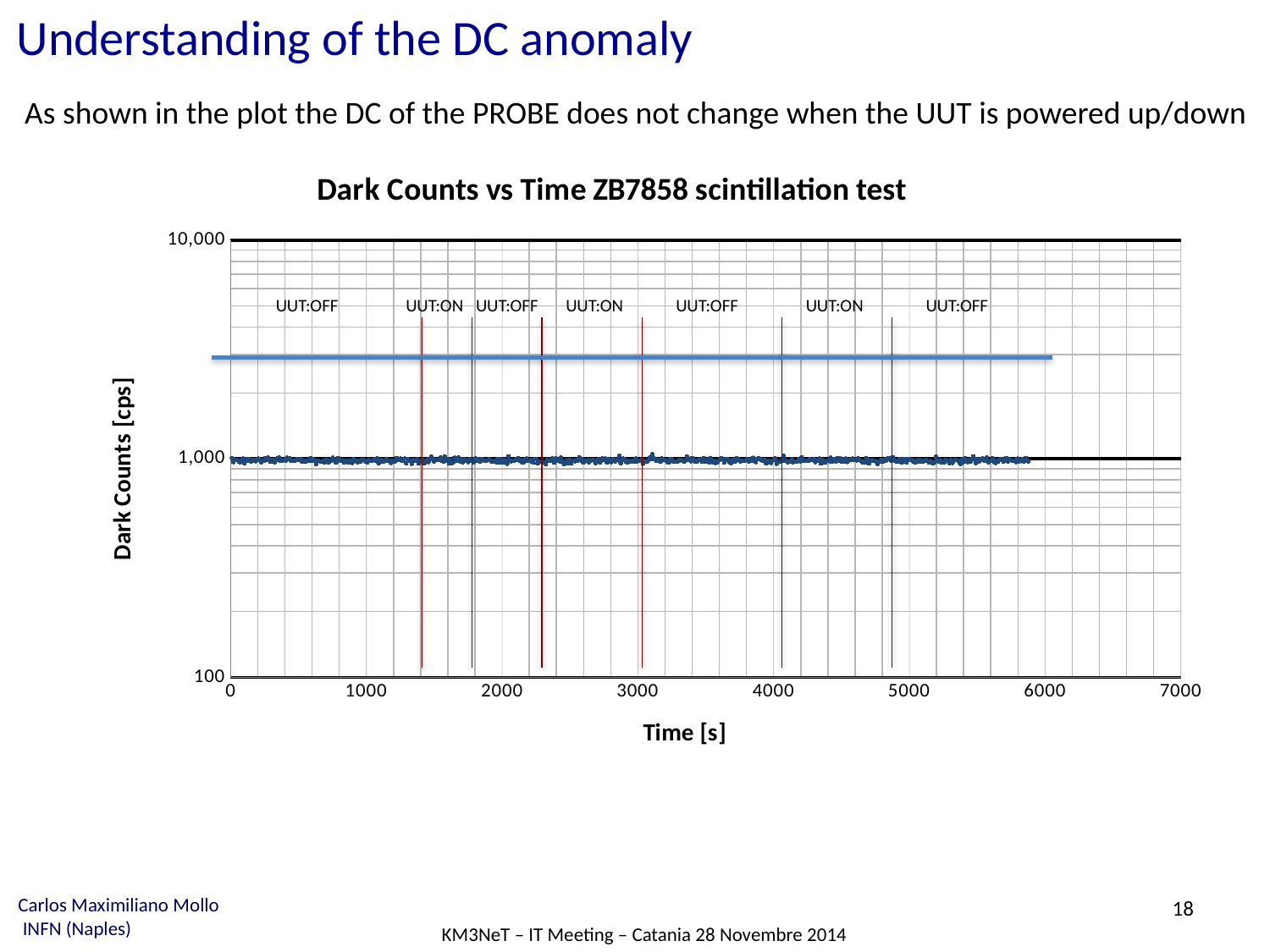
What kind of chart is shown on the slide? line chart Is the dark count value at around 500 s greater or less than 100 cps? greater Is the dark count value at around 3000 s greater or less than 10,000 cps? less What is the title of the chart? Dark Counts vs Time ZB7858 scintillation test What is the highest tick value shown on the x axis? 7000 What is the highest tick value shown on the y axis? 10,000 What is the label of the y axis of the chart? Dark Counts [cps] How many 'UUT:ON' intervals are marked on the chart? 3 Do the dark count values rise, fall, or stay roughly constant as time increases along the x axis? stay roughly constant How many 'UUT:OFF' intervals are marked on the chart? 4